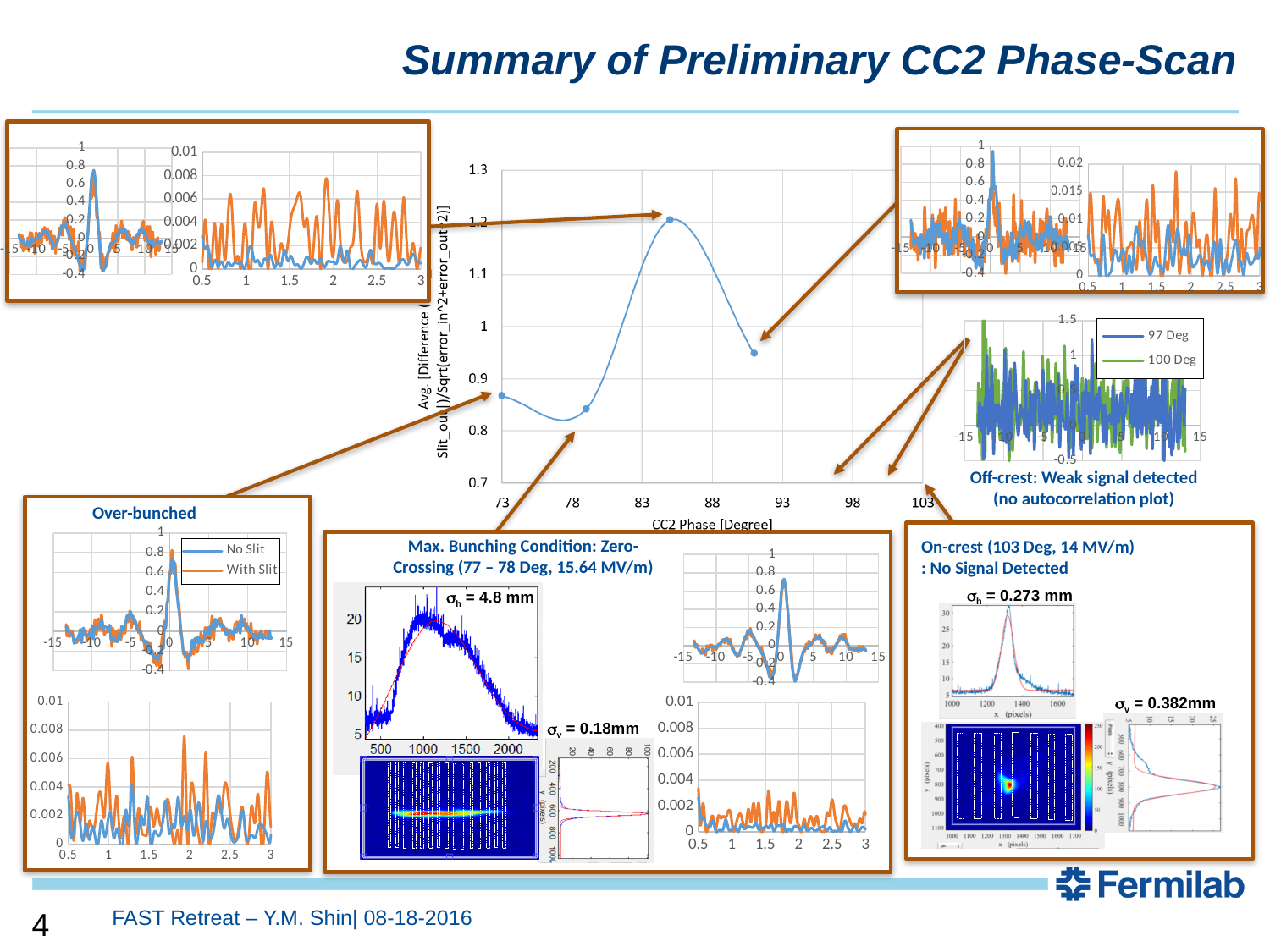
In the central chart, is the value at a CC2 phase of about 91 degrees greater or less than 1? less In the central chart, which is higher: the value at 73 degrees or the value at about 85 degrees? 85 degrees What kind of chart is the central chart plotting against CC2 Phase [Degree]? line chart In the central chart, what is the label of the x axis? CC2 Phase [Degree] In the central chart, is the value at a CC2 phase of about 79 degrees greater or less than 0.9? less How many series does the legend of the 'Over-bunched' chart on the left list? 2 In the central chart, what is the lowest value shown on the y axis? 0.7 In the central chart, does the curve rise or fall between about 85 and 91 degrees? fall In the central chart, is the value at a CC2 phase of about 85 degrees greater or less than 1.1? greater In the central chart, does the curve rise or fall between about 79 and 85 degrees? rise How many series does the legend of the 'Off-crest' chart on the right list? 2